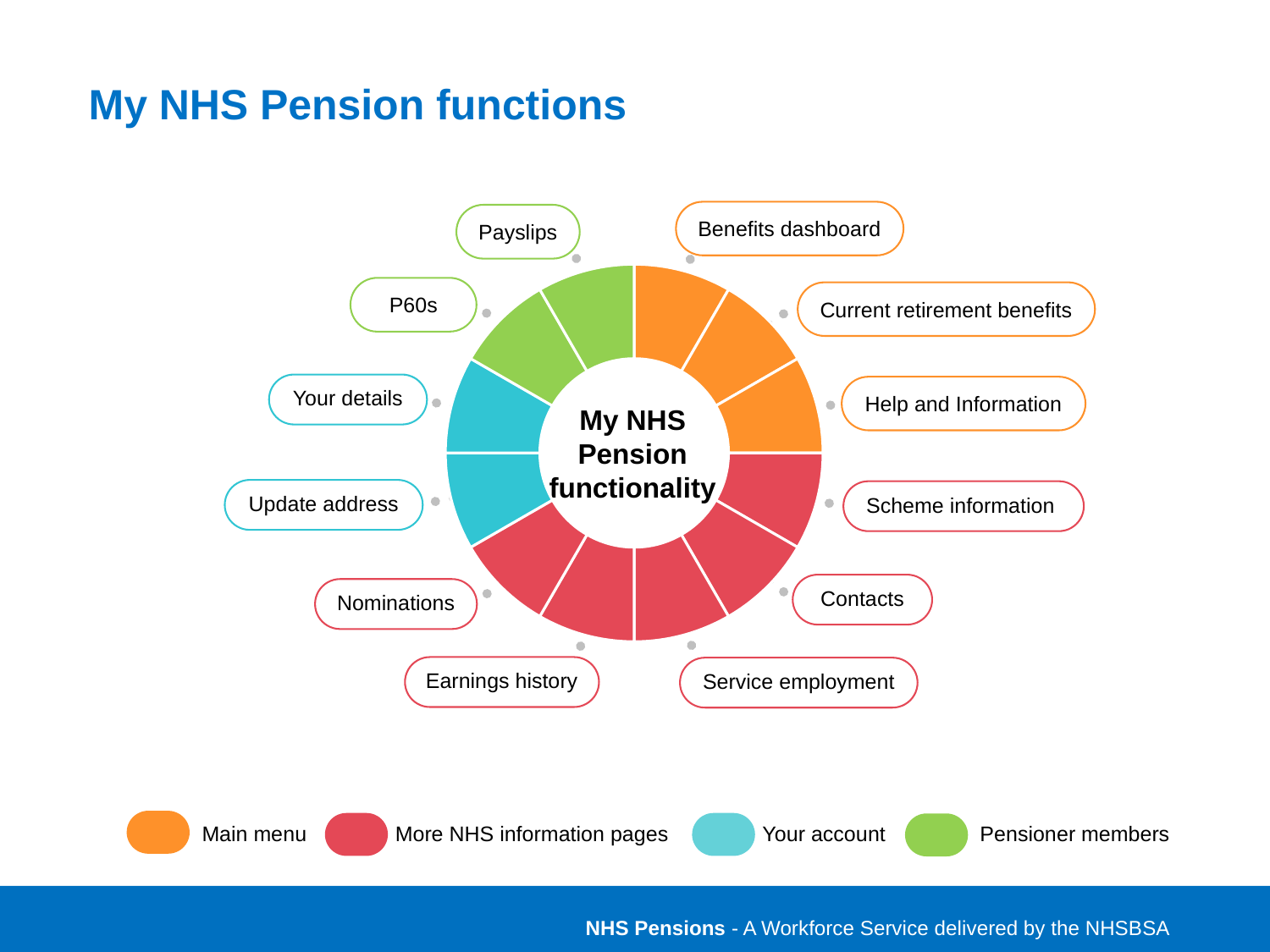
How many segments does the doughnut chart have in total? 12 What kind of chart is shown on the slide? Doughnut chart Which group has the most segments in the doughnut chart? More NHS information pages What text is written in the centre of the doughnut chart? My NHS Pension functionality Which legend group is shown in green? Pensioner members How many segments belong to the Pensioner members (green) group? 2 How many groups does the legend at the bottom of the slide list? 4 How many segments belong to the More NHS information pages (red) group? 5